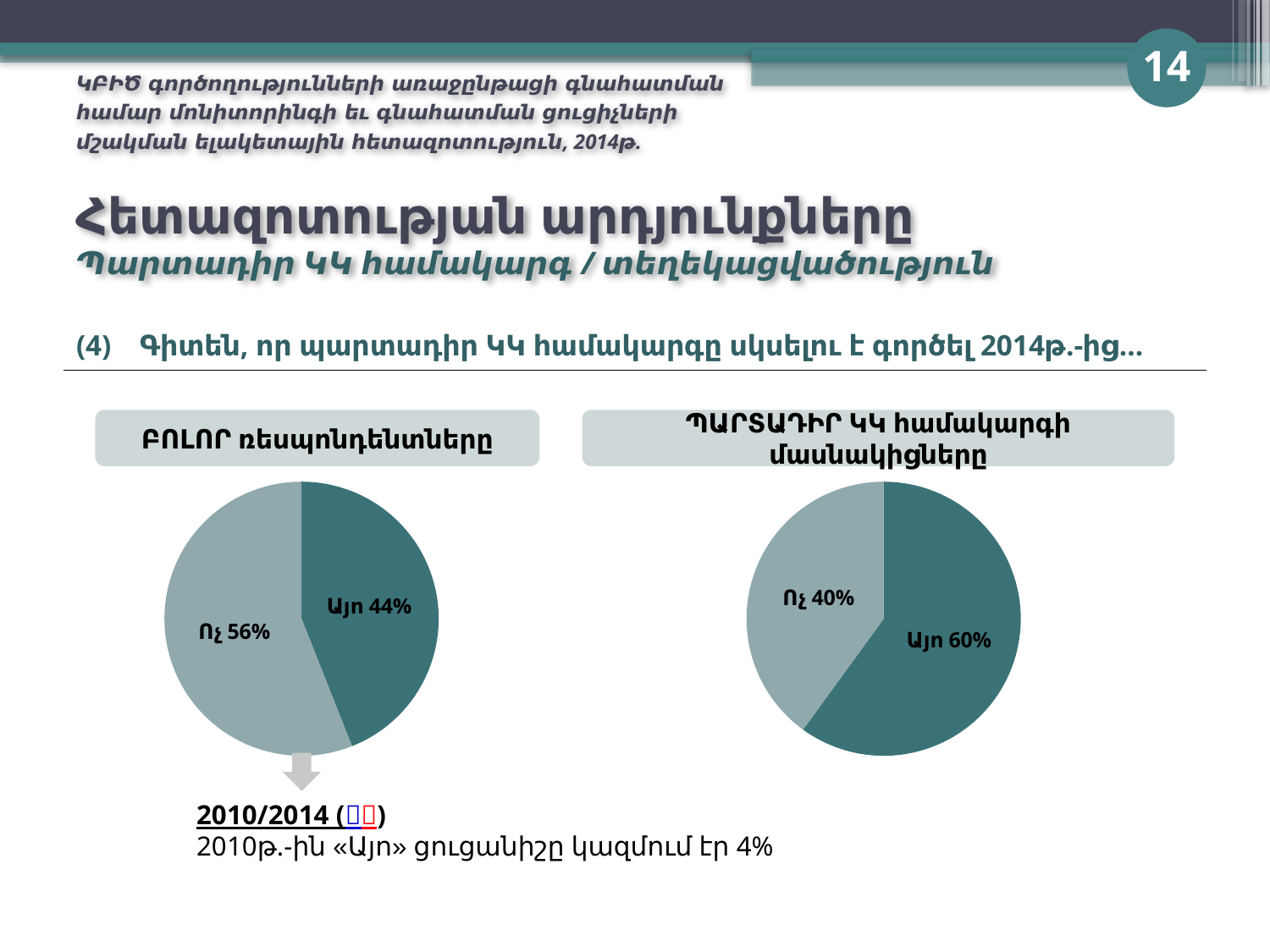
In the left pie chart, which slice is larger, Այո or Ոչ? Ոչ In the left pie chart (ԲՈԼՈՐ ռեսպոնդենտները), what share is labelled Այո? 44% How much higher is the Այո share in the right pie chart than in the left pie chart? 16% In the right pie chart, which slice is larger, Այո or Ոչ? Այո In the right pie chart (ՊԱՐՏԱԴԻՐ ԿԿ համակարգի մասնակիցները), what share is labelled Այո? 60% What is the difference between the Ոչ and Այո shares in the left pie chart? 12% What type of chart is used on this slide? Pie chart How many slices does the left pie chart have? 2 In the left pie chart (ԲՈԼՈՐ ռեսպոնդենտները), what share is labelled Ոչ? 56% What is the difference between the Այո and Ոչ shares in the right pie chart? 20% How many pie charts are shown on the slide? 2 In the right pie chart (ՊԱՐՏԱԴԻՐ ԿԿ համակարգի մասնակիցները), what share is labelled Ոչ? 40%